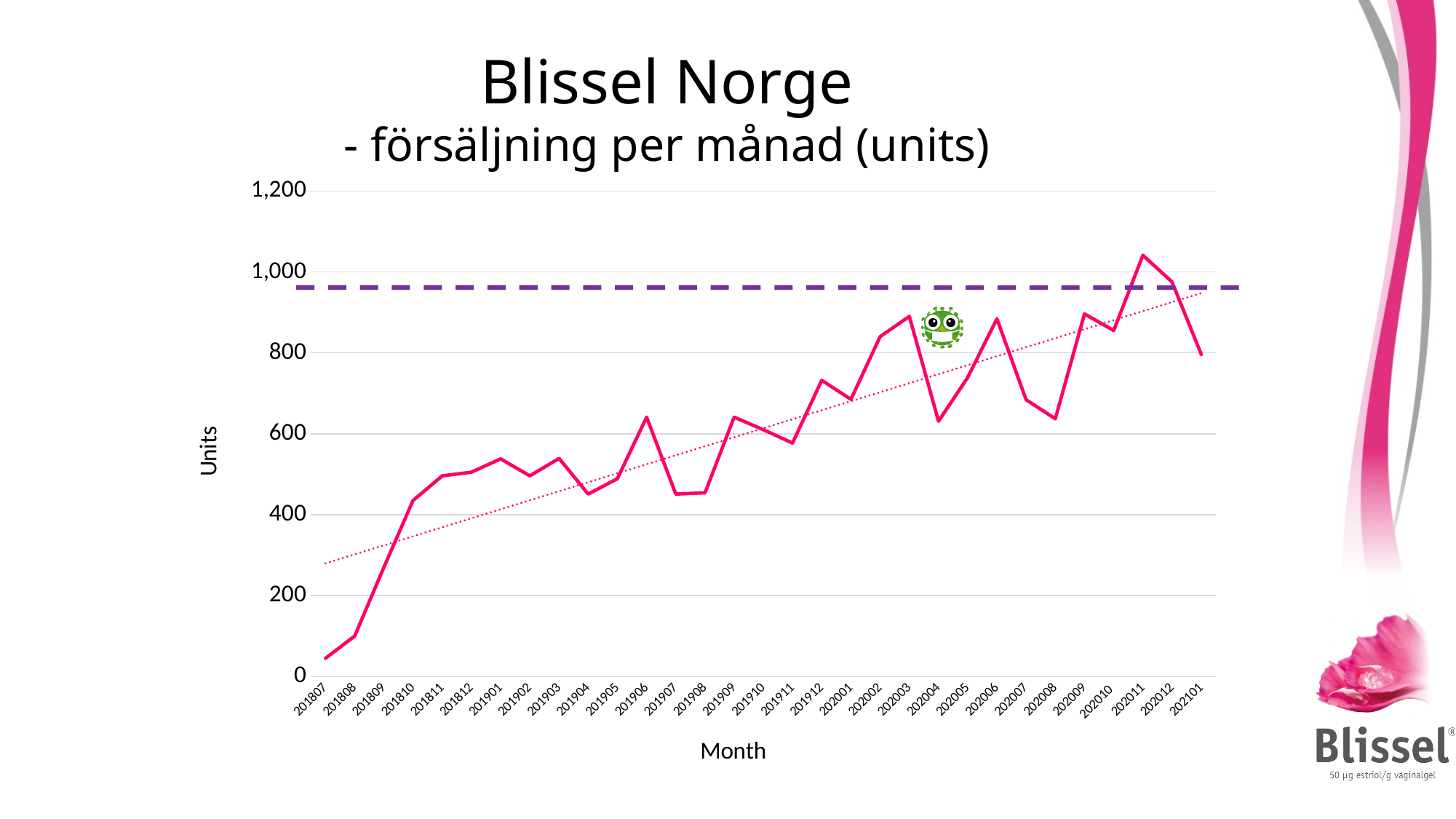
Which month has the larger value, 202003 or 202004? 202003 How many months are plotted on the x axis? 31 What is the label of the y axis? Units Is the value for 201807 greater or less than 200? less What kind of chart is shown on the slide? line chart Is the value for 201907 greater or less than 600? less Do the values generally rise or fall from 201807 to 202101? rise Is the value for 202011 greater or less than 1,000? greater Which month has the lowest value on the line? 201807 Which month has the highest value on the line? 202011